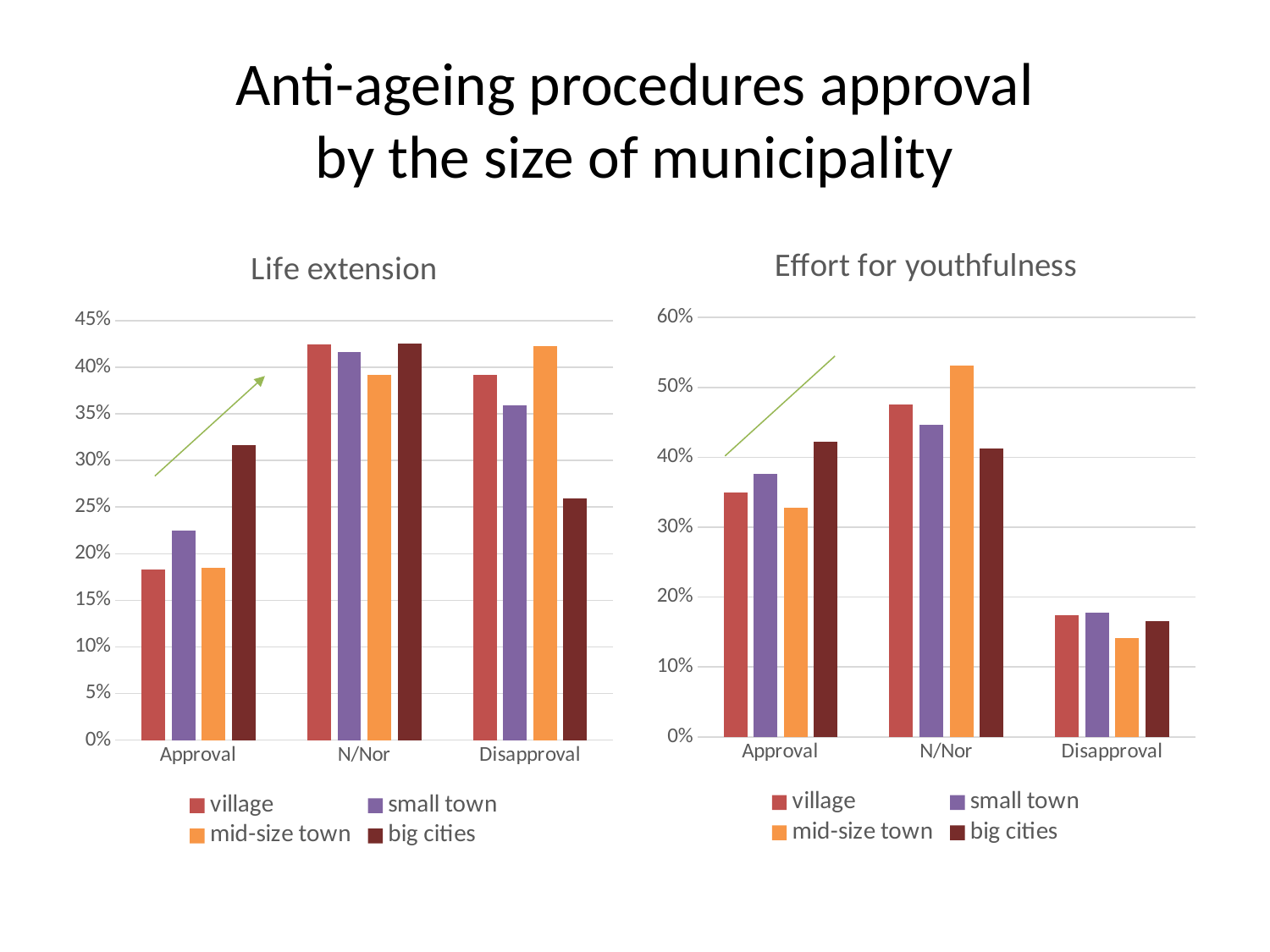
How many series does the legend of the 'Effort for youthfulness' chart list? 4 How many categories are shown on the x axis of the 'Life extension' chart? 3 What kind of chart is the 'Life extension' chart? bar chart In the 'Effort for youthfulness' chart, is the value for mid-size town in the N/Nor category greater or less than 50%? greater In the 'Life extension' chart, is the value for big cities in the Approval category greater or less than 30%? greater In the 'Life extension' chart, which series has the lowest value in the Disapproval category? big cities What is the title of the chart on the right side of the slide? Effort for youthfulness In the 'Effort for youthfulness' chart, is the value for mid-size town in the Approval category greater or less than 40%? less In the 'Life extension' chart, which is larger in the Disapproval category: village or small town? village In the 'Life extension' chart, which series has the highest value in the Approval category? big cities In the 'Effort for youthfulness' chart, which series has the lowest value in the Disapproval category? mid-size town In the 'Effort for youthfulness' chart, which is larger in the N/Nor category: mid-size town or big cities? mid-size town